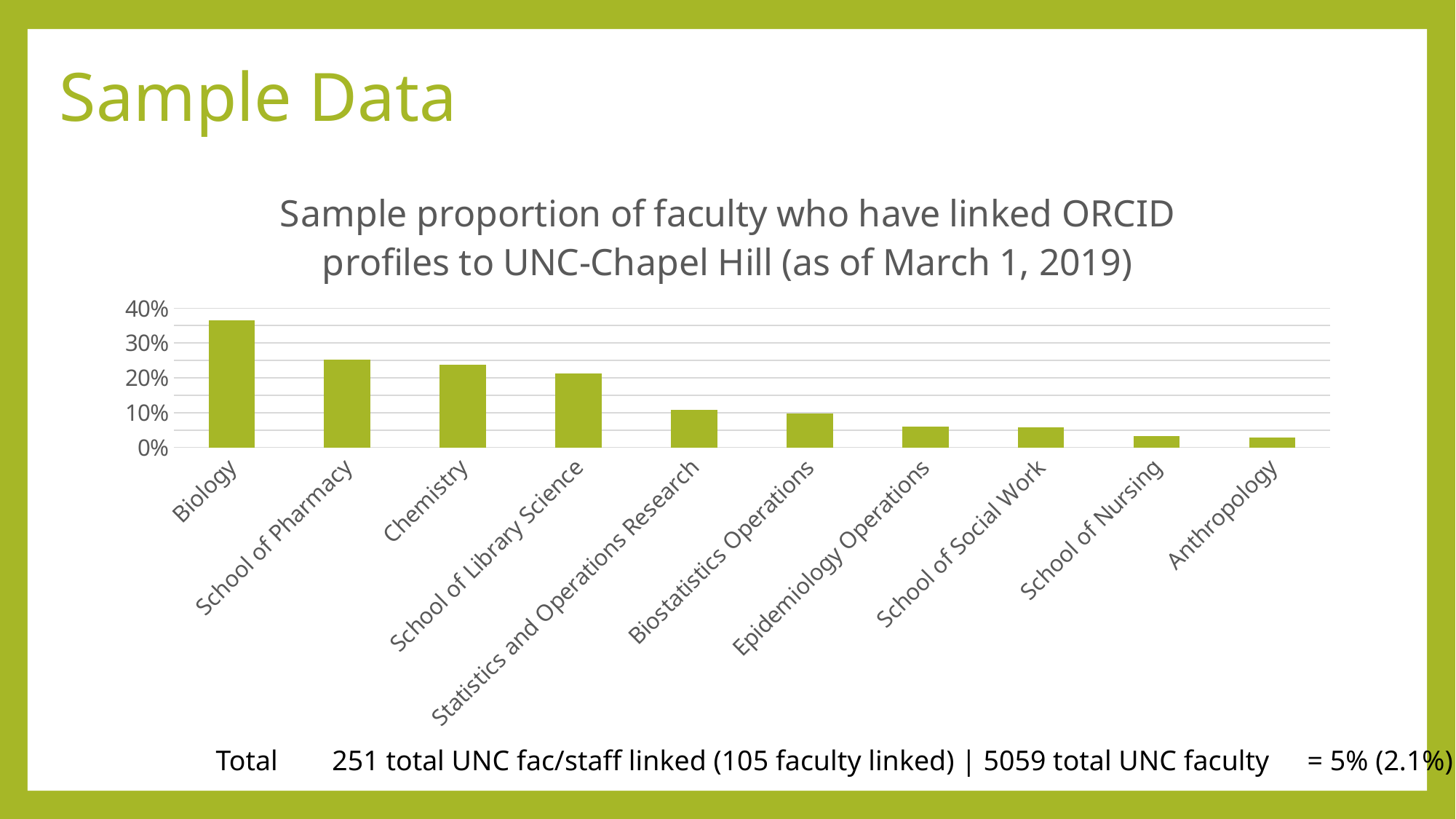
What kind of chart is shown on the slide? Bar chart What is the title of the chart? Sample proportion of faculty who have linked ORCID profiles to UNC-Chapel Hill (as of March 1, 2019) Which category has the highest proportion of faculty with linked ORCID profiles? Biology Is the value for Chemistry greater or less than 20%? greater Is the value for Anthropology greater or less than 10%? less How many categories are shown on the x axis of the chart? 10 Is the value for Epidemiology Operations greater or less than 10%? less Do the values rise or fall moving from left to right along the x axis? Fall Which is larger, the value for School of Pharmacy or the value for Statistics and Operations Research? School of Pharmacy Which is larger, the value for Biology or the value for Chemistry? Biology